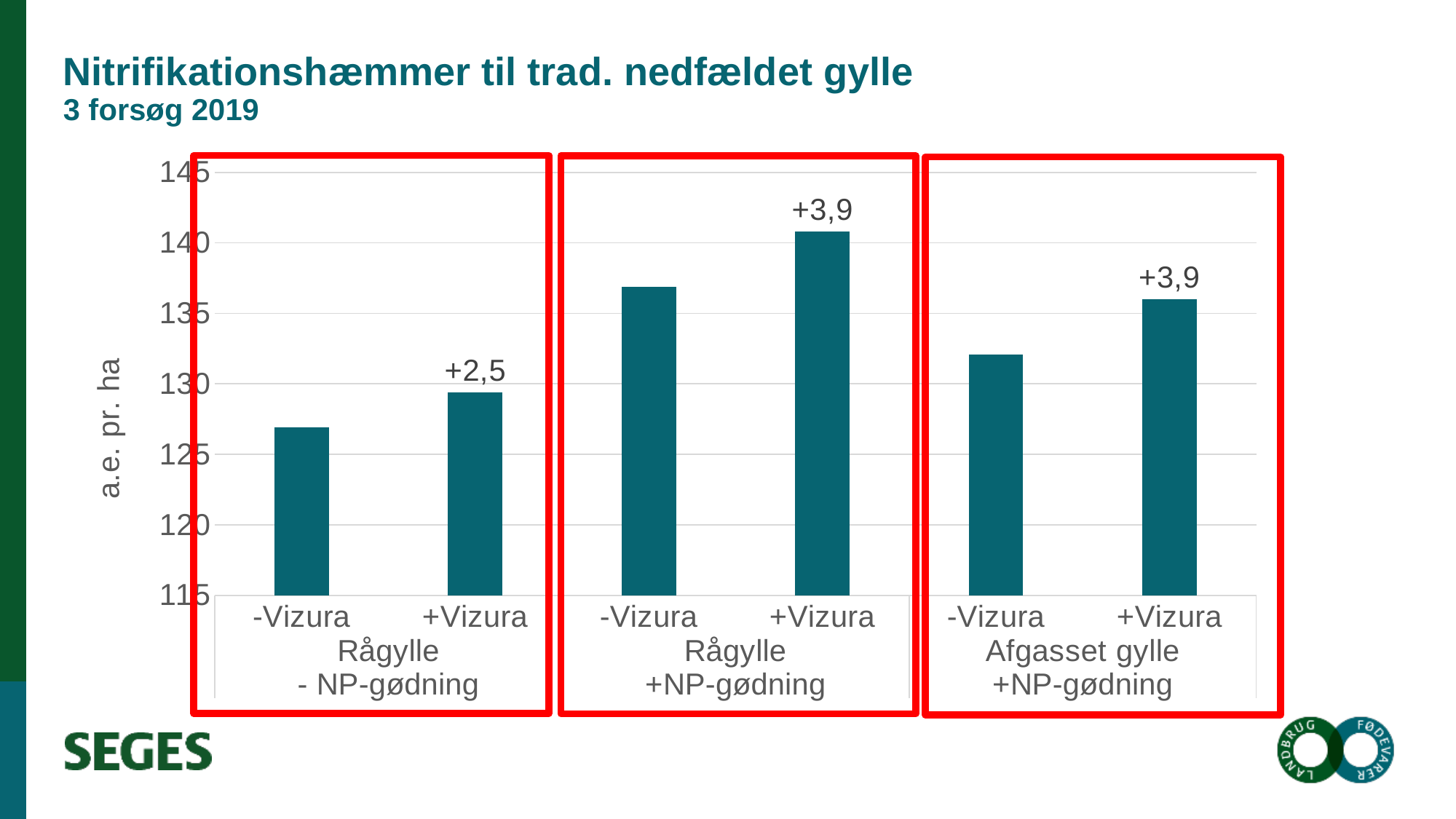
What data label is printed above the +Vizura bar in the 'Rågylle - NP-gødning' group? +2,5 Is the value for -Vizura in the 'Rågylle +NP-gødning' group greater or less than 135? greater Which bar is the highest in the chart? +Vizura, Rågylle +NP-gødning Which bar is the lowest in the chart? -Vizura, Rågylle - NP-gødning Is the value for -Vizura in the 'Afgasset gylle +NP-gødning' group greater or less than 130? greater What data label is printed above the +Vizura bar in the 'Rågylle +NP-gødning' group? +3,9 What kind of chart is shown on the slide? bar chart How many bars are plotted in the chart? 6 Which is larger: the -Vizura bar in 'Afgasset gylle +NP-gødning' or the +Vizura bar in 'Rågylle - NP-gødning'? -Vizura in Afgasset gylle +NP-gødning What is the label on the vertical axis of the chart? a.e. pr. ha How many groups of bars (treatment groups) does the chart show? 3 What data label is printed above the +Vizura bar in the 'Afgasset gylle +NP-gødning' group? +3,9